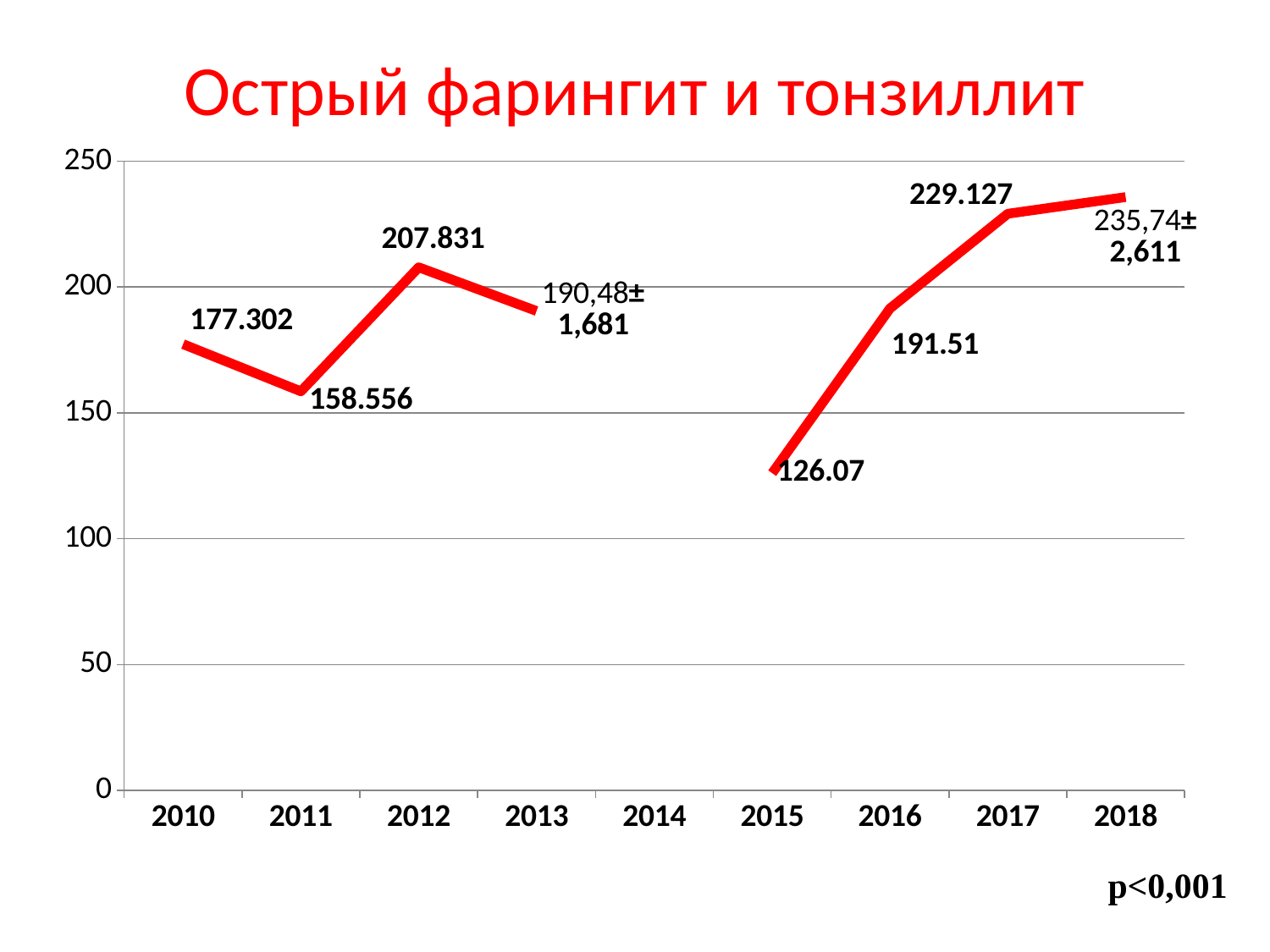
How many years are labelled on the x axis? 9 What is the value for 2012? 207.831 What is the difference between the values for 2012 and 2011? 49.275 Which year has the highest value? 2018 Which year has the lowest value? 2015 What is the value for 2017? 229.127 What is the value for 2010? 177.302 Which is larger, the value for 2016 or the value for 2010? 2016 Is the value for 2015 greater or less than 150? less What is the value for 2015? 126.07 Do the values rise or fall from 2015 to 2018? rise What kind of chart is shown? line chart